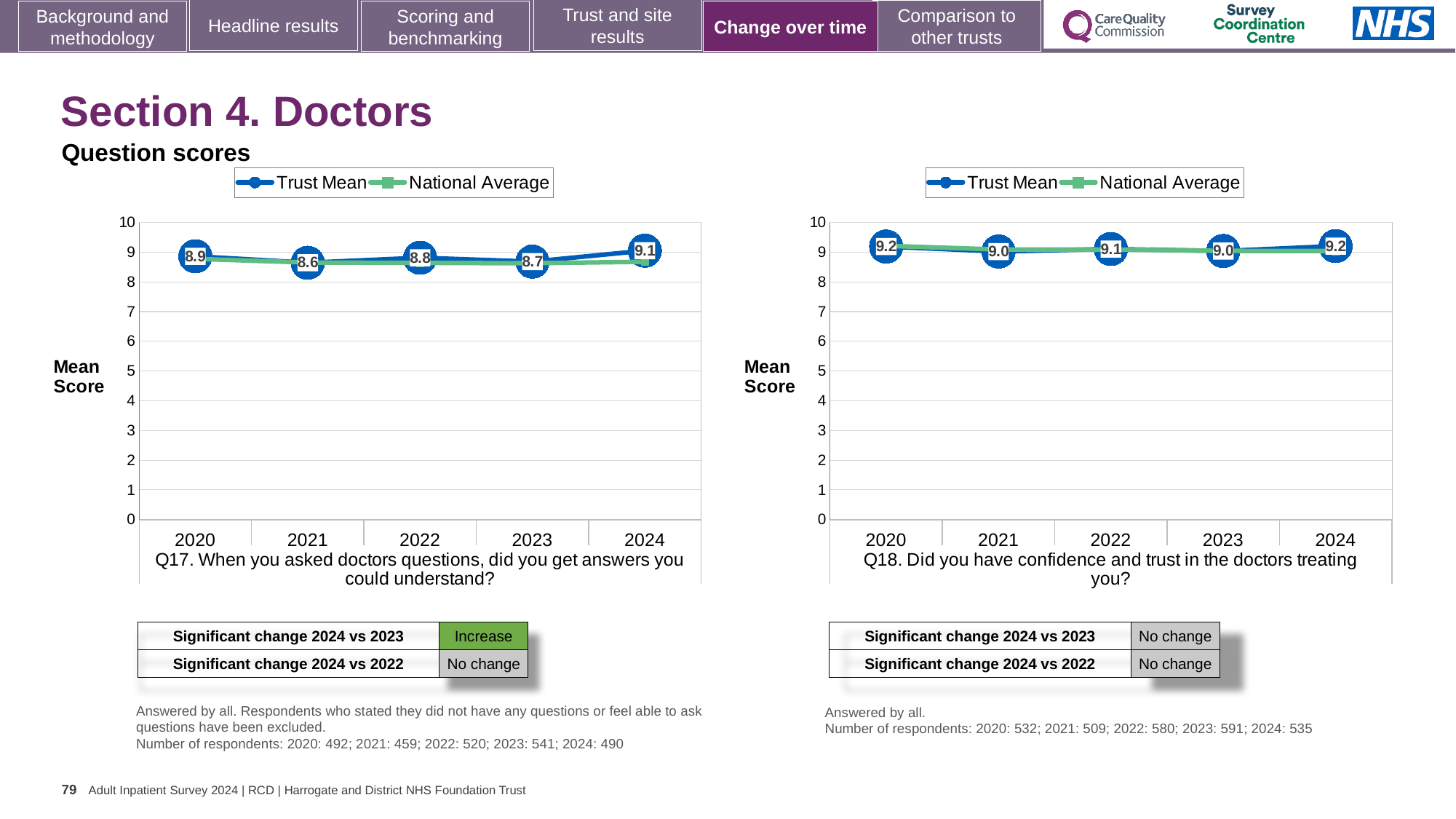
In the Q17 chart, which series is shown in blue? Trust Mean In the Q18 chart, what is the Trust Mean score for 2022? 9.1 In the Q17 chart, what is the Trust Mean score for 2021? 8.6 In the Q17 chart, which year has the highest Trust Mean score? 2024 In the Q18 chart, is the Trust Mean score for 2020 greater or less than 8? greater What kind of chart is the Q18 chart? Line chart In the Q18 chart, what is the difference between the Trust Mean scores for 2024 and 2023? 0.2 How many years are plotted on the x axis of the Q18 chart? 5 In the Q17 chart, what is the Trust Mean score for 2024? 9.1 In the Q17 chart, what is the difference between the Trust Mean scores for 2024 and 2021? 0.5 In the Q17 chart, which year has the lowest Trust Mean score? 2021 How many series does the legend of the Q17 chart list? 2